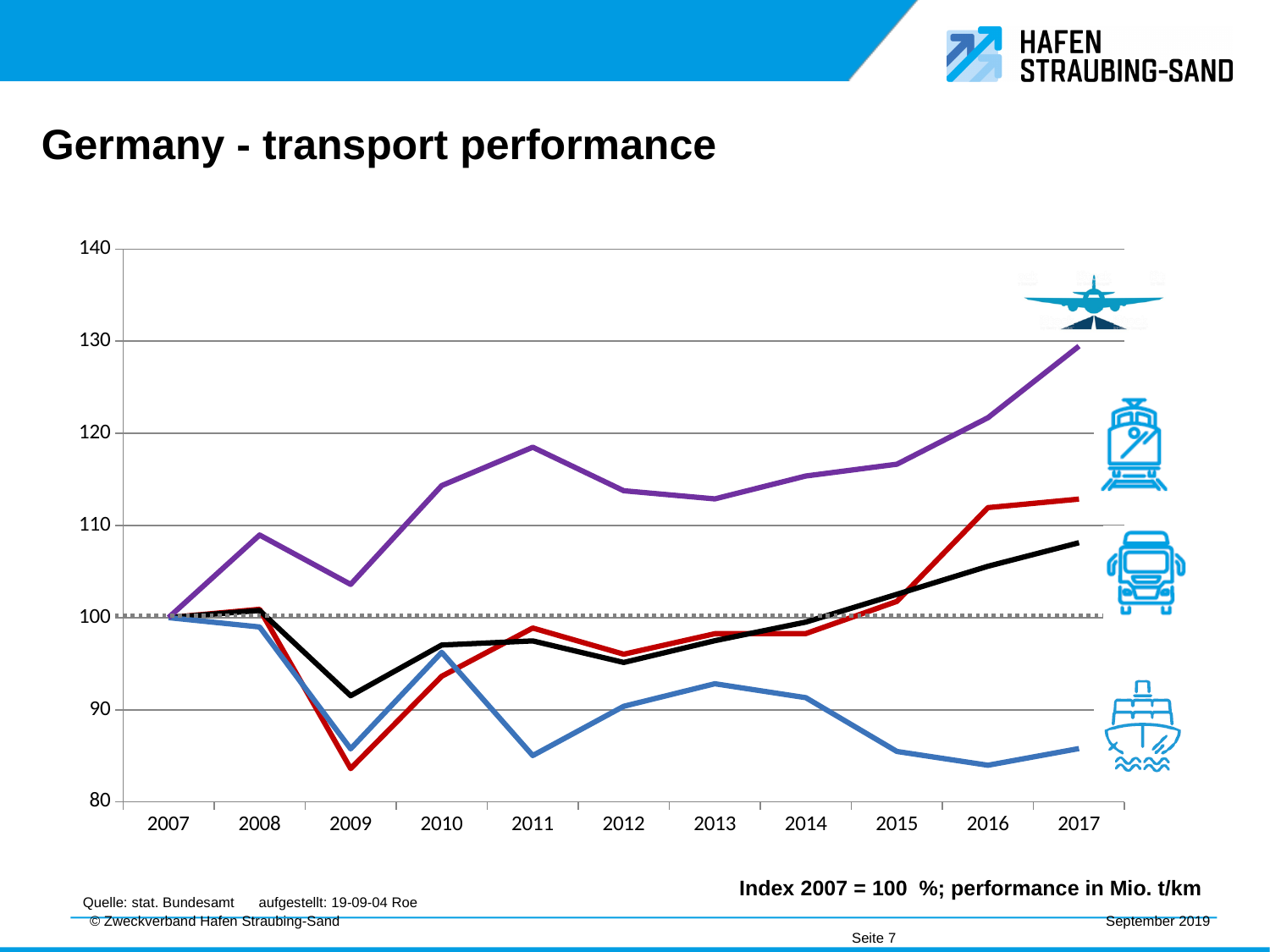
What is the index value of all series in 2007? 100 Does the purple line rise or fall between 2013 and 2017? rise How many lines (series) are plotted on the chart? 4 Which line has the lowest value in 2017? the blue line What kind of chart is shown on the slide? line chart How many years are shown along the x axis of the chart? 11 Is the value of the blue line in 2009 greater or less than 90? less Which line has the highest value in 2017? the purple line Is the value of the black line in 2017 greater or less than 100? greater In 2017, which is larger: the red line or the black line? the red line Is the value of the purple line in 2017 greater or less than 120? greater What is the title of the slide's chart? Germany - transport performance